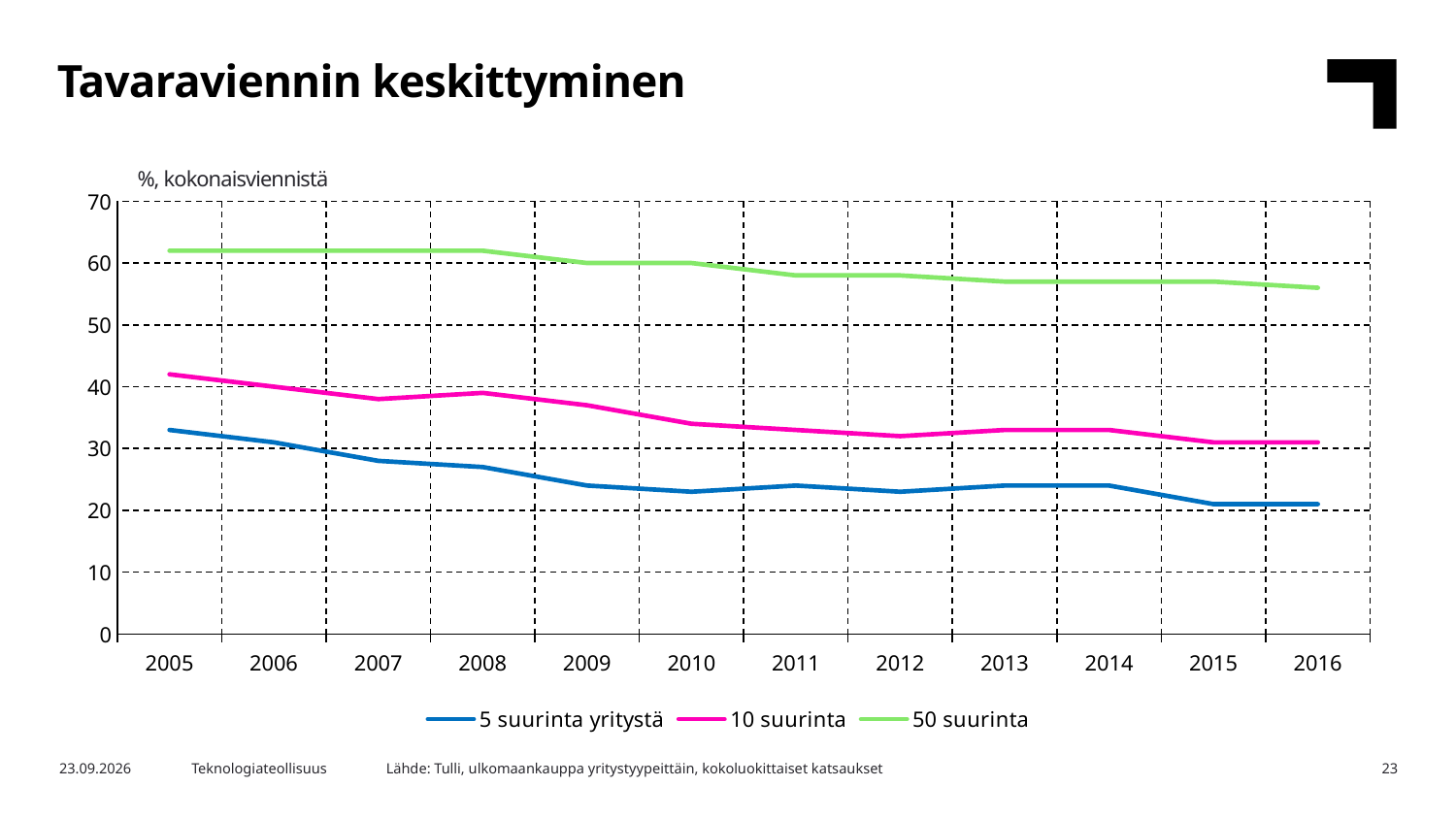
How many series does the legend list? 3 What unit label is shown above the y axis? %, kokonaisviennistä What is the title of the chart? Tavaraviennin keskittyminen What kind of chart is shown on the slide? line chart Is the value for 10 suurinta in 2005 greater or less than 40? greater Does the 5 suurinta yritystä series rise or fall from 2005 to 2016? fall Is the value for 5 suurinta yritystä in 2016 greater or less than 30? less Is the value for 5 suurinta yritystä in 2005 greater or less than 30? greater Which series has the higher value in 2010, 50 suurinta or 5 suurinta yritystä? 50 suurinta How many years are shown on the x axis? 12